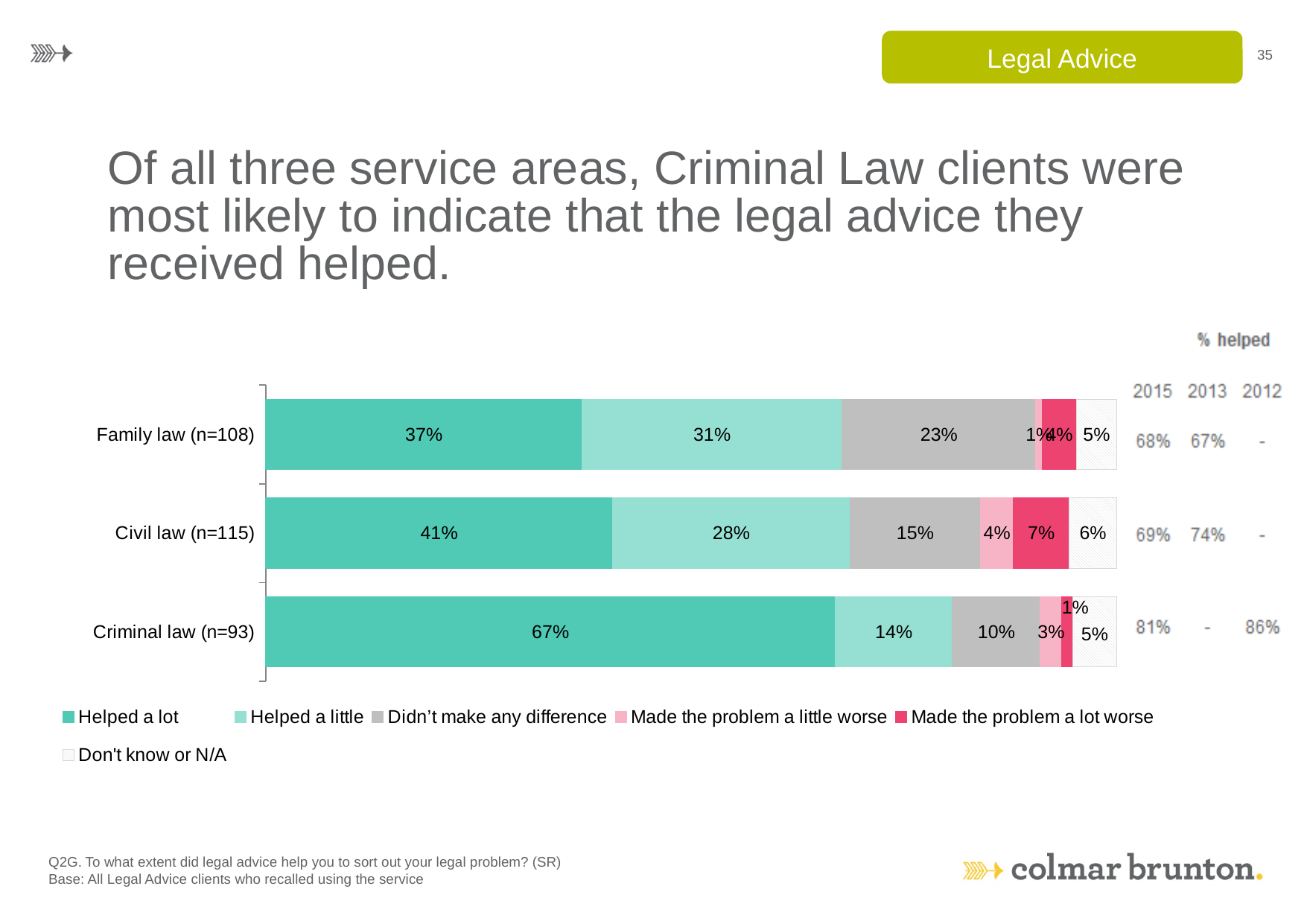
What is the difference between the 'Helped a lot' percentages for Criminal law and Civil law? 26 percentage points What percentage of Criminal law clients said the legal advice helped a lot? 67% What percentage of Family law clients said the legal advice helped a lot? 37% What percentage of Civil law clients said the advice made the problem a lot worse? 7% What percentage of Civil law clients said the advice didn't make any difference? 15% How many service areas (categories) are shown in the chart? 3 According to the '% helped' table, what was the 2015 figure for Criminal law? 81% Which service area has the lowest share of clients saying the advice helped a lot? Family law (n=108) Which is larger: the 'Helped a little' share for Family law or for Criminal law? Family law Which service area has the highest share of clients saying the advice helped a lot? Criminal law (n=93) What kind of chart is shown on the slide? Stacked bar chart How many series does the legend list? 6